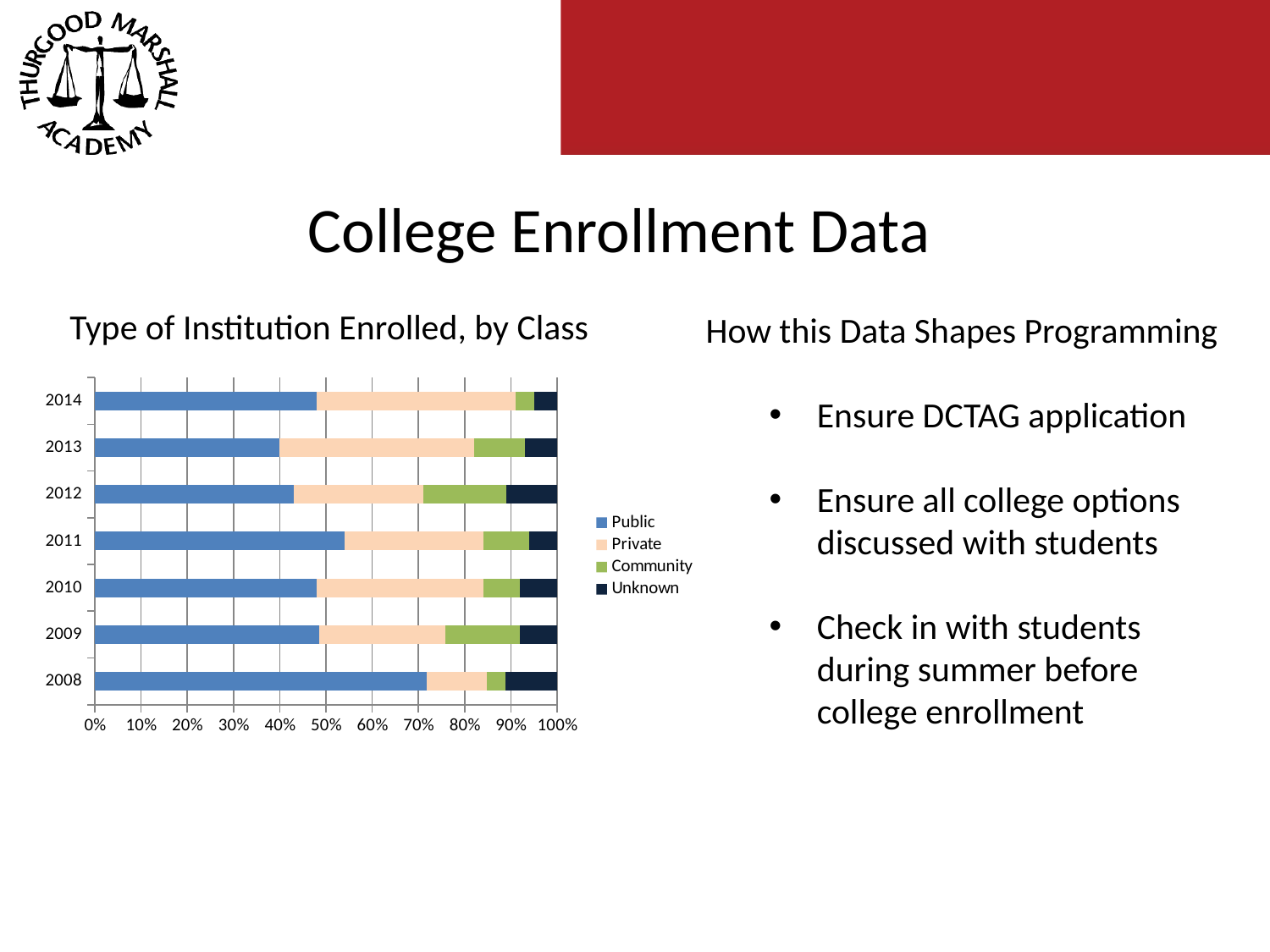
Which class has the larger Community share, 2012 or 2014? 2012 Which series are listed in the chart's legend? Public, Private, Community, Unknown What kind of chart is shown on the slide? Stacked bar chart Is the Public share for the class of 2014 greater or less than 40%? greater Which class has the largest Public share? 2008 What is the highest value shown on the chart's x axis? 100% Which class has the larger Public share, 2008 or 2013? 2008 How many series does the chart's legend list? 4 What is the title of the chart? Type of Institution Enrolled, by Class Is the Public share for the class of 2008 greater or less than 60%? greater How many classes (years) are shown on the chart? 7 Is the Public share for the class of 2013 greater or less than 50%? less